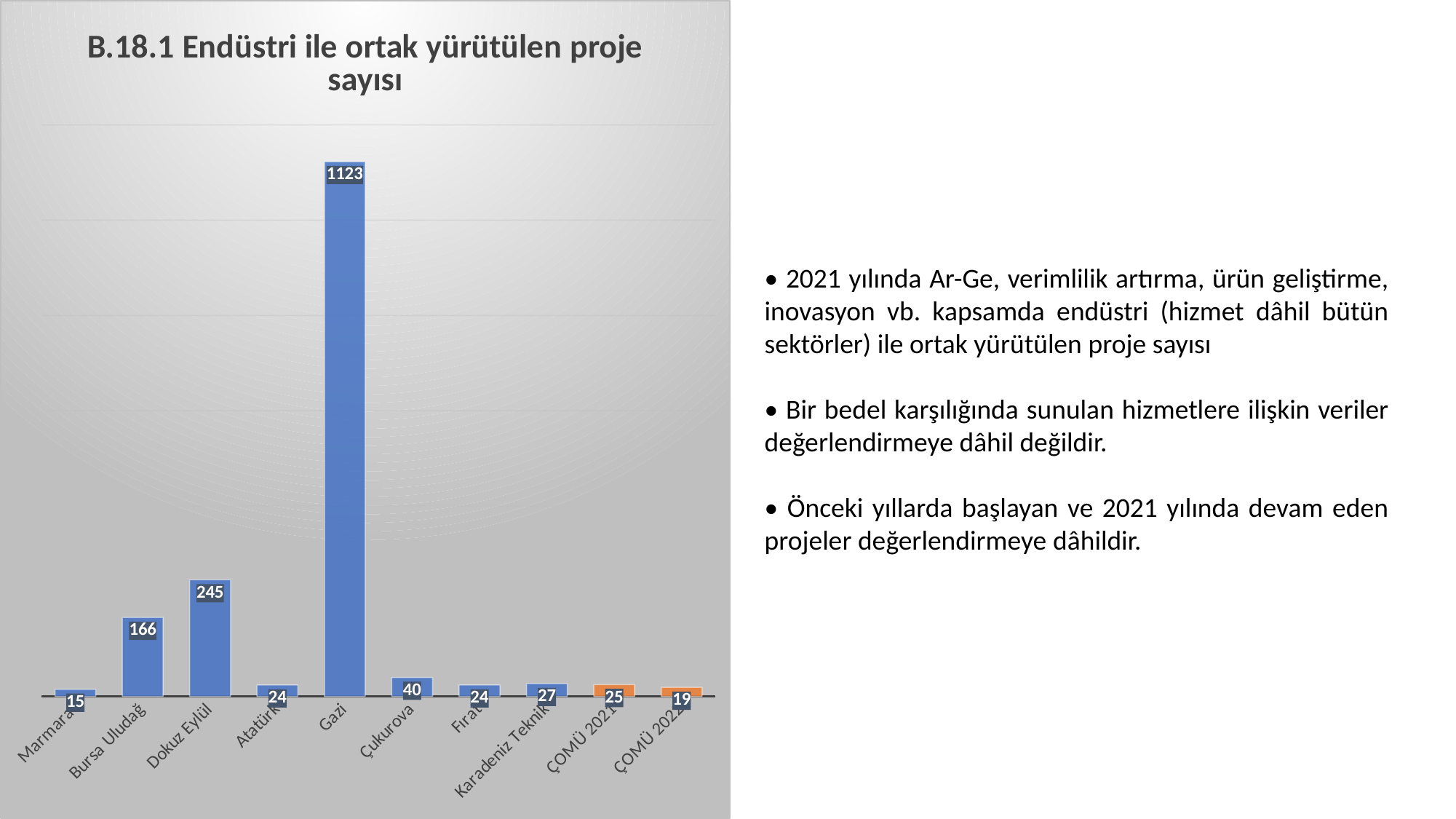
What kind of chart is shown on the slide? Bar chart What is the value for Dokuz Eylül? 245 What is the title of the chart? B.18.1 Endüstri ile ortak yürütülen proje sayısı Which category has the lowest value? Marmara What is the value for ÇOMÜ 2022? 19 What is the difference between the values for Dokuz Eylül and Bursa Uludağ? 79 How many categories are shown on the x axis? 10 What is the difference between the values for ÇOMÜ 2021 and ÇOMÜ 2022? 6 What is the value for Bursa Uludağ? 166 Which is larger, the value for Çukurova or the value for Karadeniz Teknik? Çukurova Which category has the highest value? Gazi What is the value for Gazi in the chart? 1123